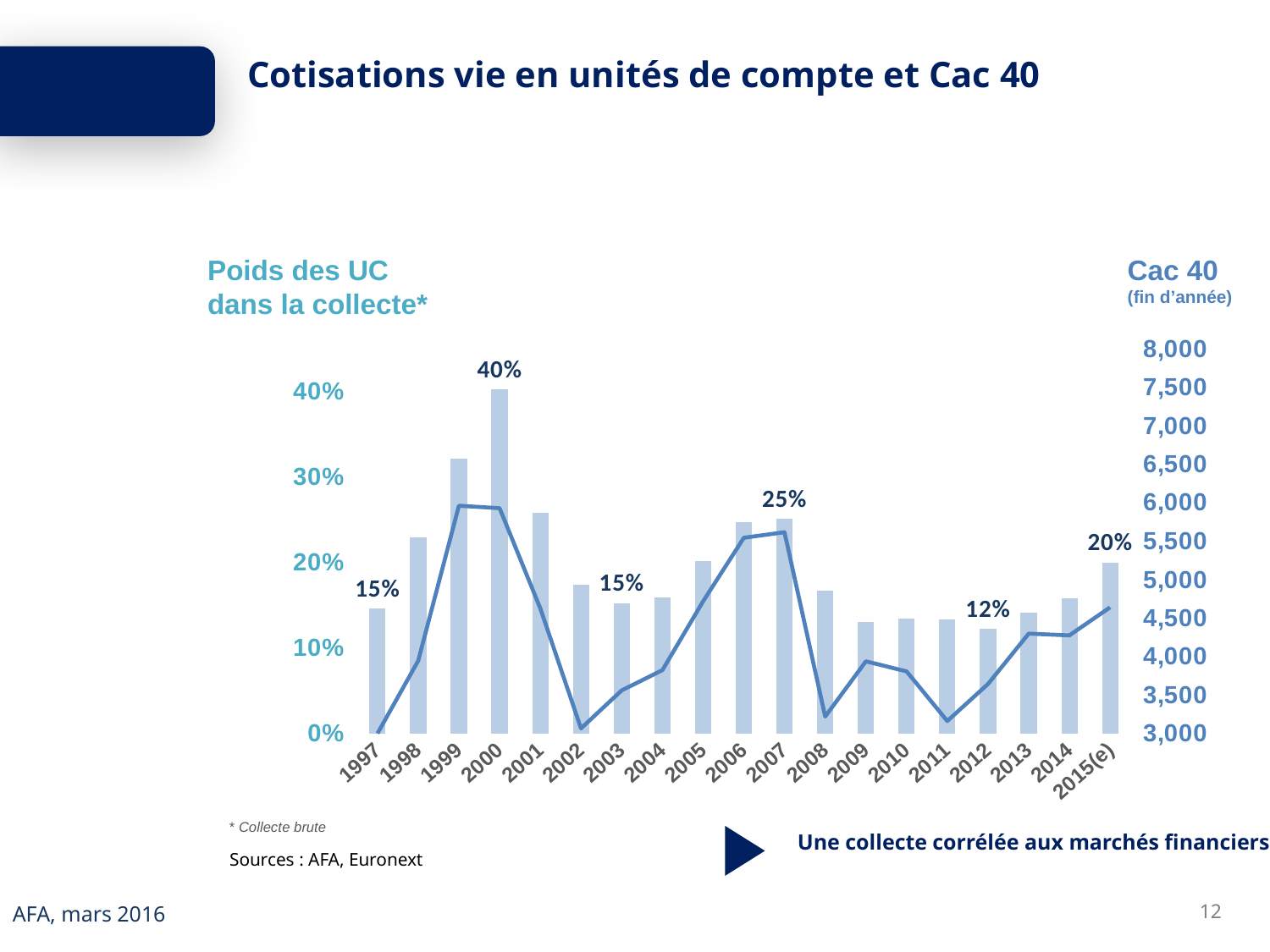
What is the title of the right-hand axis? Cac 40 (fin d'année) What is the value of the 'Poids des UC dans la collecte' bar for 2000? 40% What share of the collecte did unités de compte represent in 2007? 25% Is the Cac 40 line value for 2002 greater or less than 3,500? less What is the labelled value for 2015(e)? 20% Which is larger, the bar for 2007 or the bar for 2015(e)? 2007 Is the bar value for 2001 greater or less than 30%? less Which year has the highest bar for the weight of UC in the collecte? 2000 By how much does the 2015(e) value exceed the 2012 value? 8 percentage points What is the difference between the 2000 value (40%) and the 2007 value (25%)? 15 percentage points How many years are shown on the x axis? 19 What is the labelled value for 2012? 12%